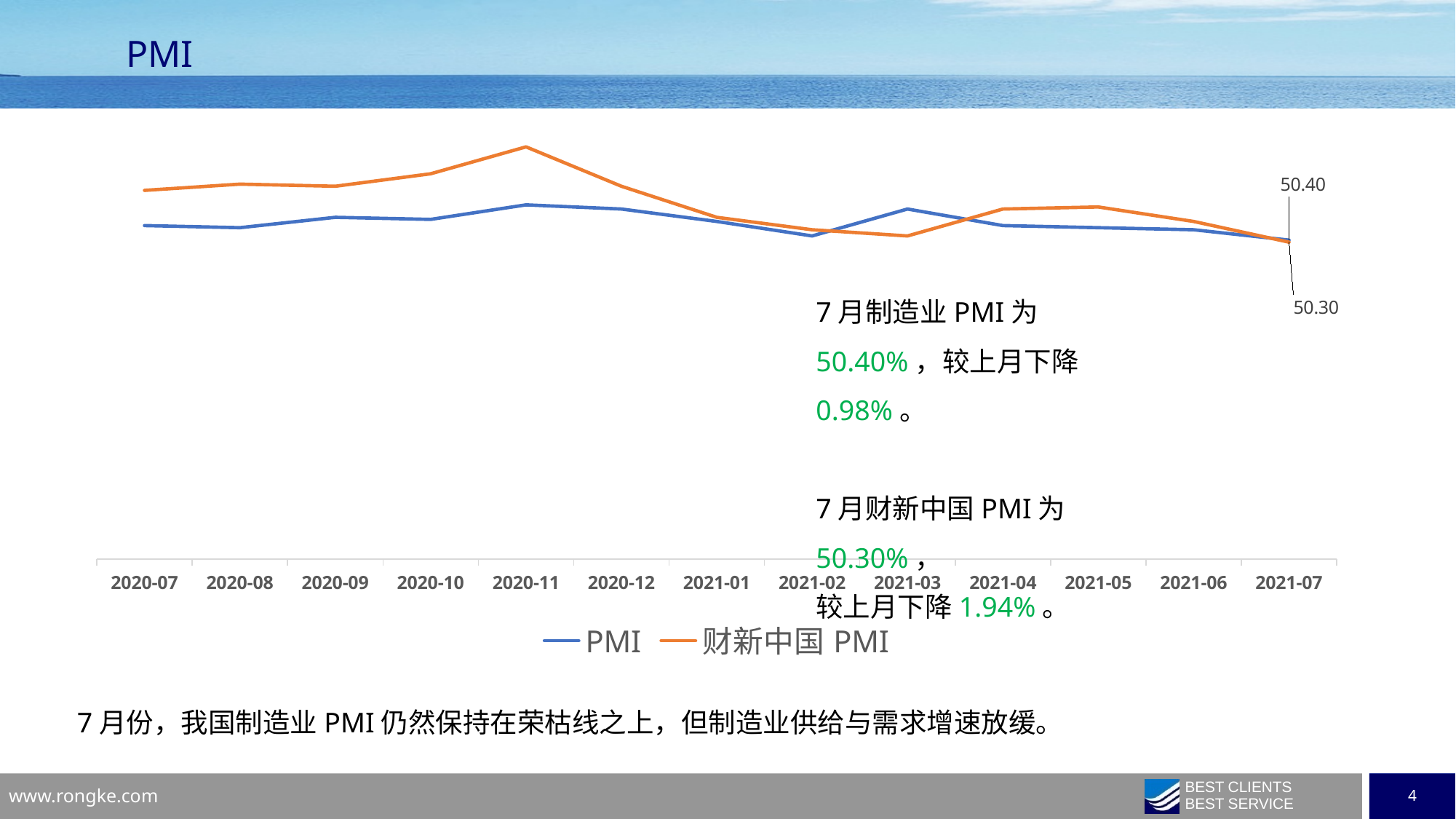
Does 财新中国 PMI rise or fall from 2020-11 to 2021-03? fall What is the difference between PMI and 财新中国 PMI in 2021-07? 0.10 In 2020-11, which series is higher, PMI or 财新中国 PMI? 财新中国 PMI In 2021-03, which series is higher, PMI or 财新中国 PMI? PMI In 2021-07, which series has the larger value, PMI or 财新中国 PMI? PMI What is the value of 财新中国 PMI for 2021-07? 50.30 In which month does 财新中国 PMI reach its highest value? 2020-11 What is the value of PMI for 2021-07? 50.40 How many series does the legend list? 2 How many months are shown on the x axis? 13 What kind of chart is shown on the slide? line chart What colour is the PMI line? blue